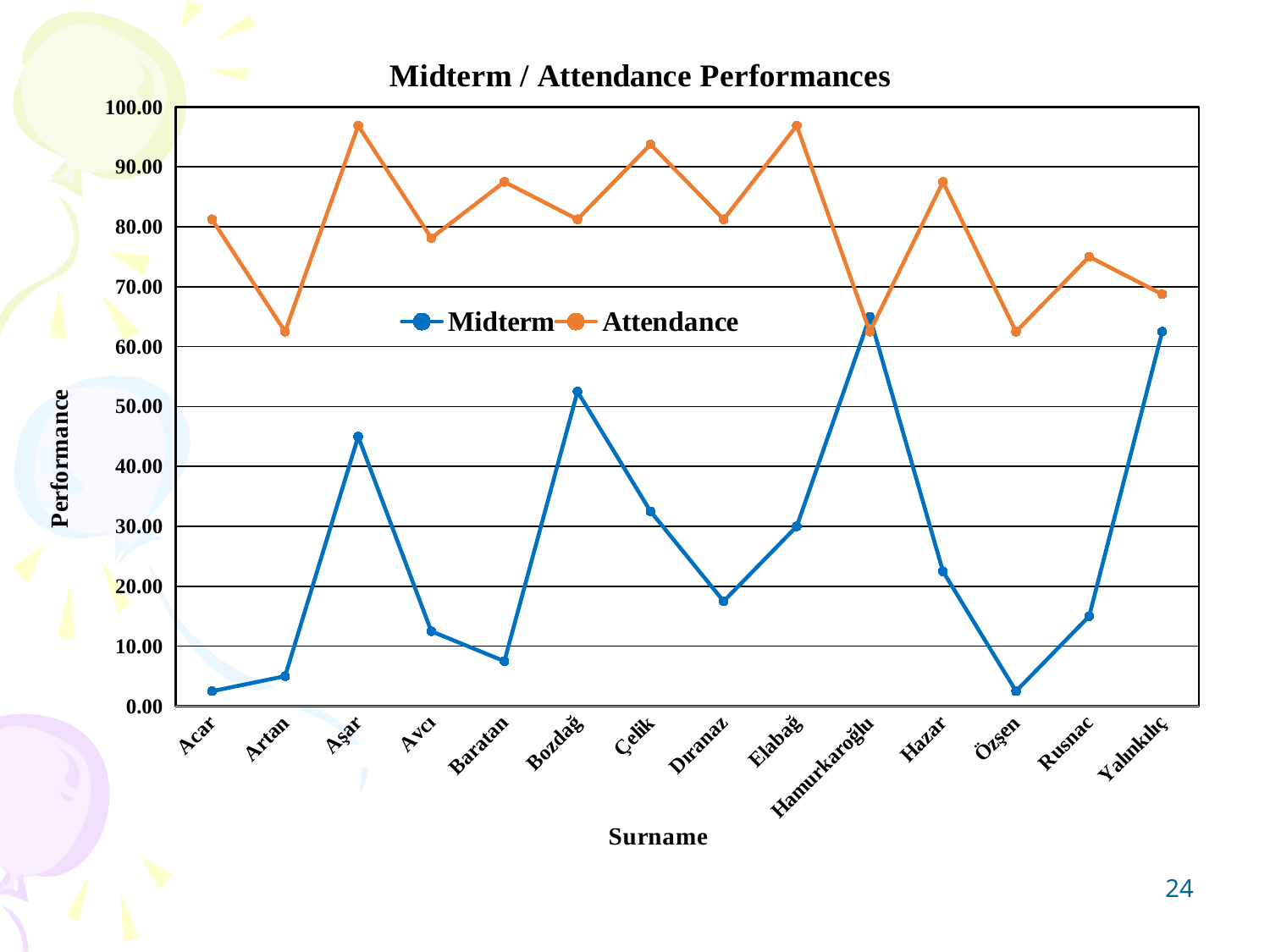
Is the Attendance value for Avcı greater or less than 80.00? less What kind of chart is shown on the slide? line chart How many surnames are plotted along the x axis? 14 Is the Attendance value for Çelik greater or less than 90.00? greater Is the Midterm value for Aşar greater or less than 50.00? less Which has the larger Attendance value, Baratan or Artan? Baratan Which has the larger Midterm value, Aşar or Çelik? Aşar What is the title of the chart? Midterm / Attendance Performances What is the label of the y axis? Performance How many series does the legend list? 2